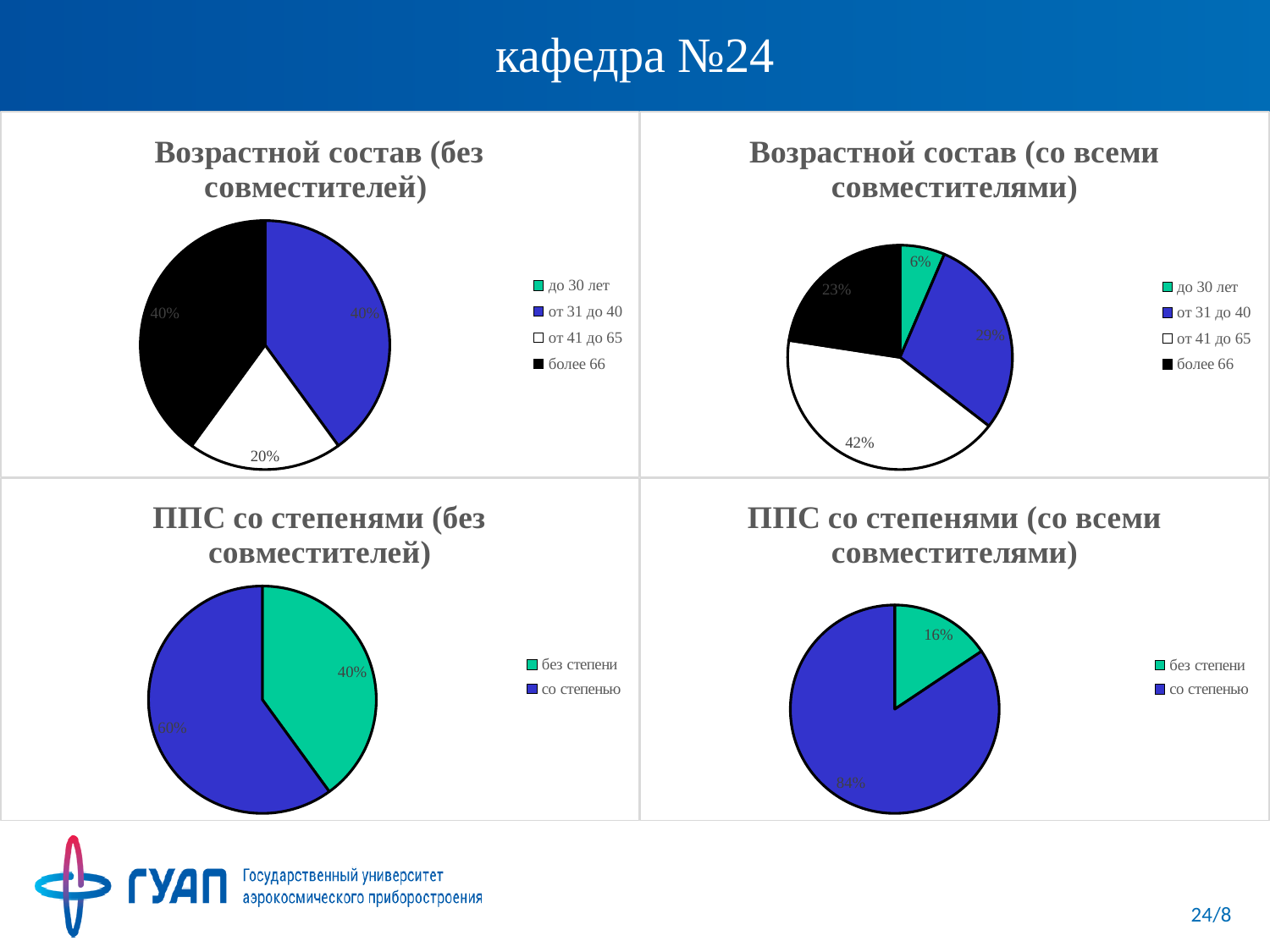
In the chart 'ППС со степенями (со всеми совместителями)', which category has the larger share: 'без степени' or 'со степенью'? со степенью In the chart 'Возрастной состав (со всеми совместителями)', which age group has the largest share? от 41 до 65 How many charts are shown on the slide? 4 In the chart 'Возрастной состав (со всеми совместителями)', what is the difference between the shares for 'от 41 до 65' and 'до 30 лет'? 36 percentage points How many entries does the legend of the chart 'Возрастной состав (без совместителей)' list? 4 In the chart 'ППС со степенями (без совместителей)', what share is labelled for 'без степени'? 40% In the chart 'Возрастной состав (со всеми совместителями)', which age group has the smallest share? до 30 лет In the chart 'ППС со степенями (со всеми совместителями)', what share is labelled for 'без степени'? 16% In the chart 'Возрастной состав (без совместителей)', what share is labelled for 'от 41 до 65'? 20% What type of chart is 'ППС со степенями (без совместителей)'? Pie chart In the chart 'Возрастной состав (со всеми совместителями)', what share is labelled for 'до 30 лет'? 6% In the chart 'Возрастной состав (со всеми совместителями)', what share is labelled for 'от 41 до 65'? 42%